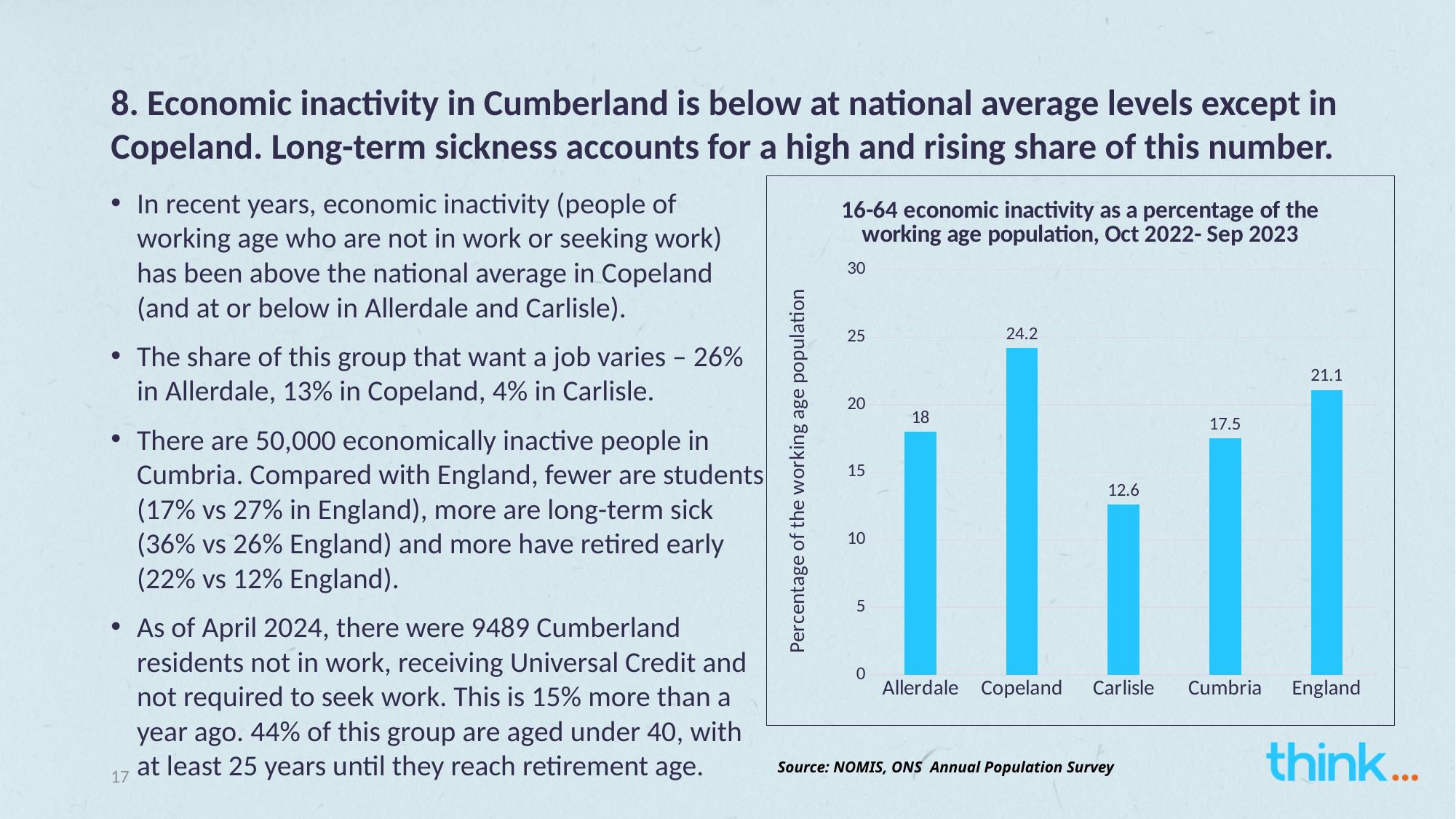
What is the economic inactivity percentage for Allerdale? 18 What kind of chart is shown on the slide? Bar chart Is the value for Carlisle greater or less than 15? less What is the economic inactivity percentage for Carlisle? 12.6 What is the economic inactivity percentage for Copeland? 24.2 What is the difference between the economic inactivity percentages for Allerdale and Cumbria? 0.5 How many areas are shown in the chart? 5 Which area has the lowest economic inactivity percentage? Carlisle Which has a higher economic inactivity percentage, Cumbria or England? England What is the economic inactivity percentage for England? 21.1 Which area has the highest economic inactivity percentage? Copeland What is the difference between the economic inactivity percentages for Copeland and England? 3.1